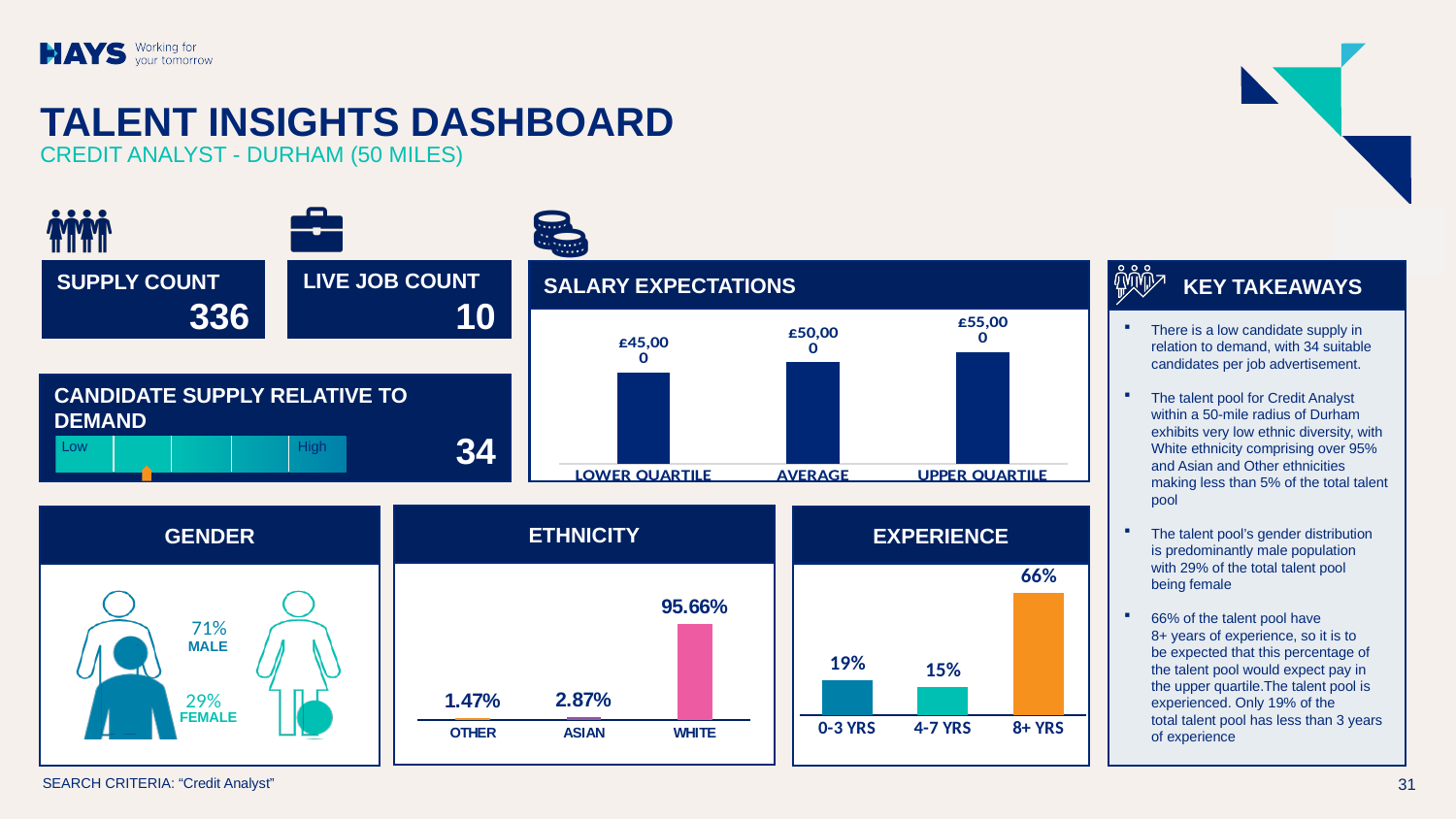
In the Salary Expectations chart, what is the value for Lower Quartile? £45,000 In the Salary Expectations chart, what is the value for Upper Quartile? £55,000 What kind of chart is the Experience chart? bar chart In the Ethnicity chart, which category has the lowest value? Other In the Ethnicity chart, which category has the highest value? White In the Experience chart, what is the value for 4-7 YRS? 15% In the Ethnicity chart, how many categories are shown? 3 In the Ethnicity chart, what is the value for Asian? 2.87% In the Experience chart, which is larger, 0-3 YRS or 4-7 YRS? 0-3 YRS In the Experience chart, what is the difference between 8+ YRS and 0-3 YRS? 47% In the Salary Expectations chart, do the values rise or fall from Lower Quartile to Upper Quartile? rise In the Salary Expectations chart, what is the difference between the Upper Quartile and the Average? £5,000